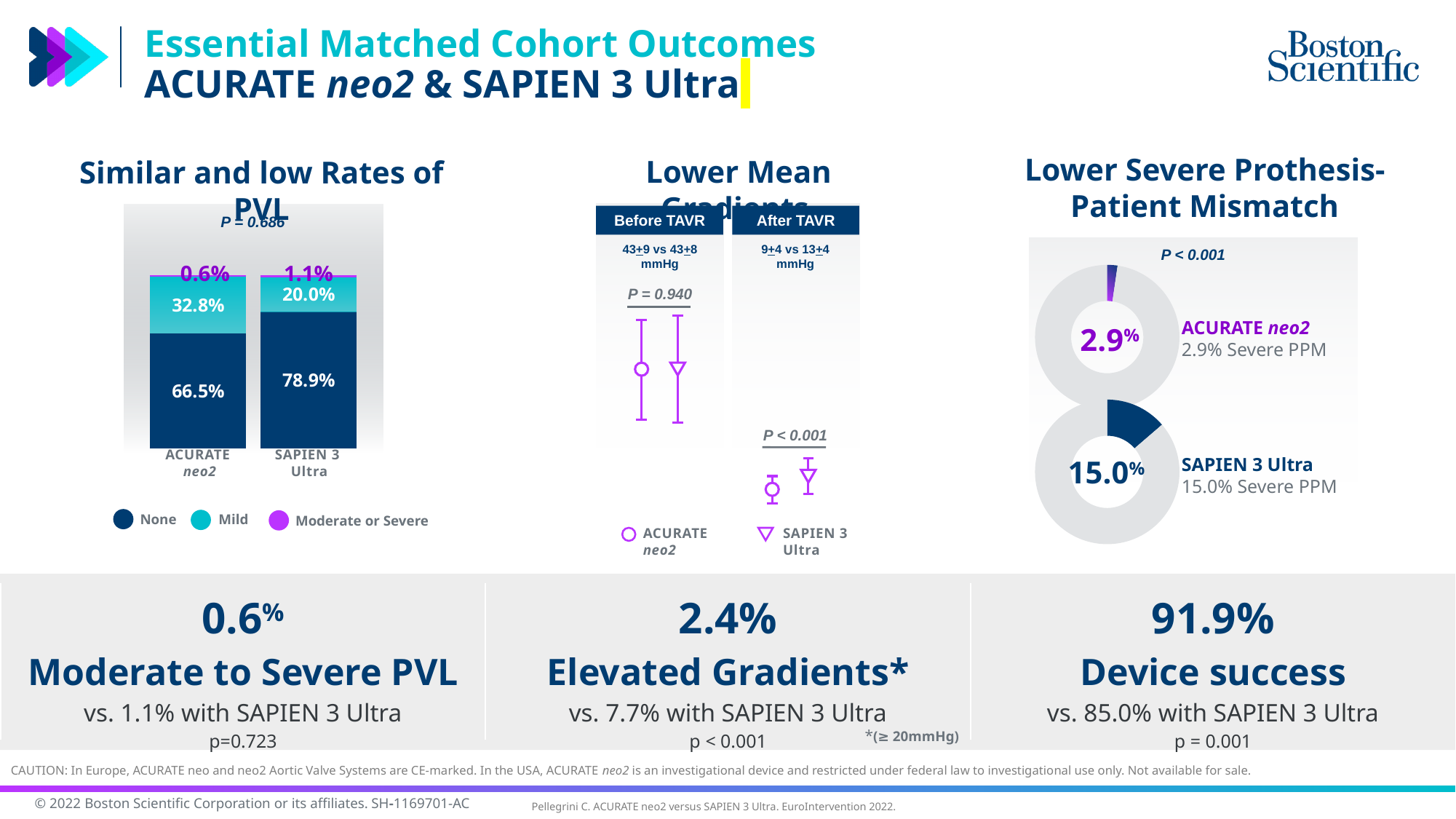
In the 'Lower Severe Prothesis-Patient Mismatch' chart, what is the difference between the severe PPM rates of SAPIEN 3 Ultra and ACURATE neo2? 12.1 percentage points In the 'Similar and low Rates of PVL' chart, what is the value for Mild in the SAPIEN 3 Ultra bar? 20.0% In the 'Lower Mean Gradients' chart, what is the After TAVR mean gradient for SAPIEN 3 Ultra? 13±4 mmHg In the 'Lower Mean Gradients' chart, what is the Before TAVR mean gradient for ACURATE neo2? 43±9 mmHg How many series does the legend of the 'Similar and low Rates of PVL' chart list? 3 In the 'Similar and low Rates of PVL' chart, what is the difference between the None values for SAPIEN 3 Ultra and ACURATE neo2? 12.4 percentage points In the 'Similar and low Rates of PVL' chart, what is the value for None in the ACURATE neo2 bar? 66.5% What kind of chart is the 'Similar and low Rates of PVL' chart? Stacked bar chart How many bars are shown in the 'Similar and low Rates of PVL' chart? 2 In the 'Lower Mean Gradients' chart, which marker shape represents SAPIEN 3 Ultra in the legend? Triangle In the 'Similar and low Rates of PVL' chart, which valve has the larger Mild value? ACURATE neo2 In the 'Lower Severe Prothesis-Patient Mismatch' chart, what is the severe PPM rate for ACURATE neo2? 2.9%